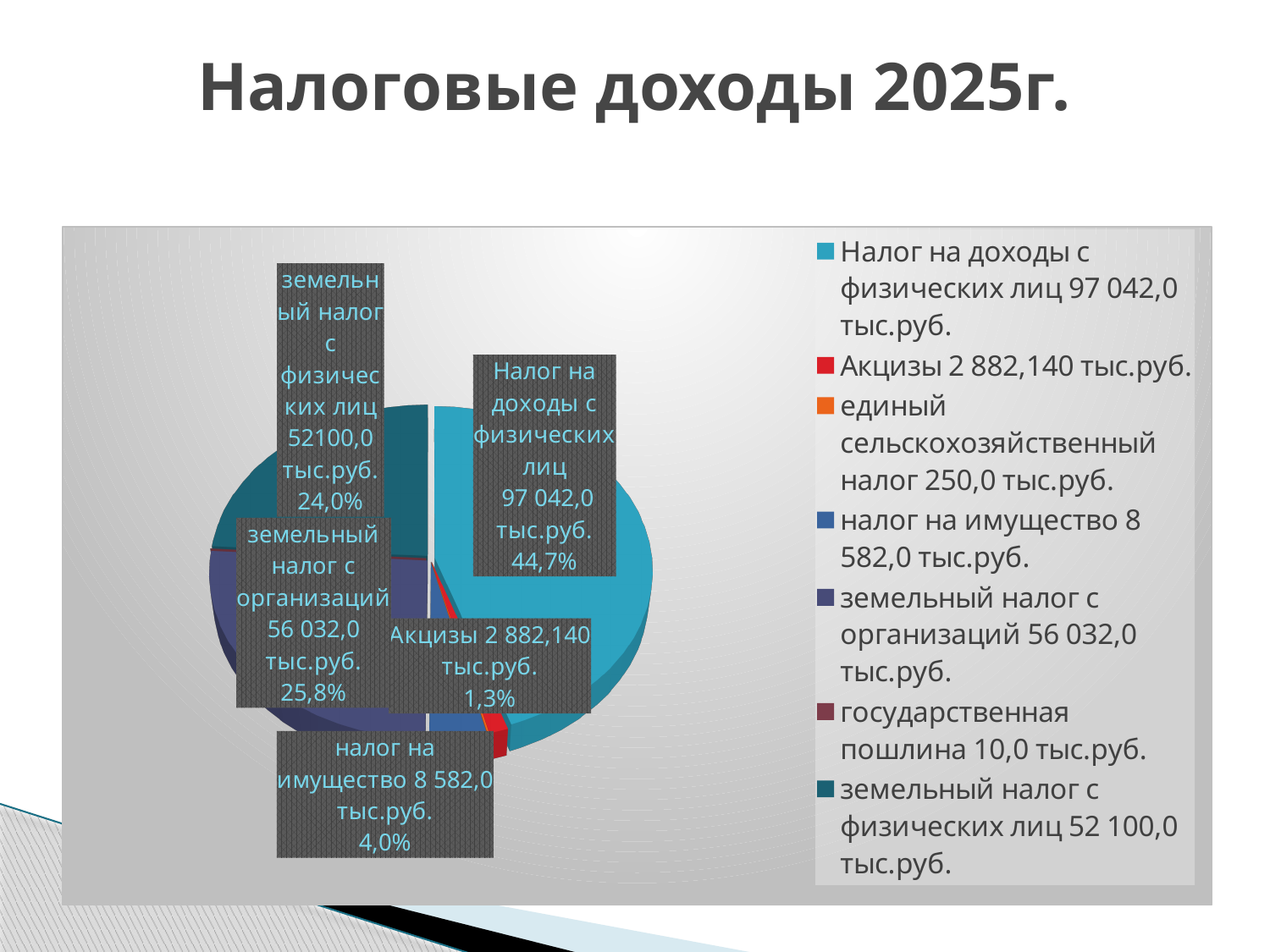
What share of the pie does "Налог на доходы с физических лиц" have? 44,7% Which is larger: the share for "земельный налог с организаций" or the share for "налог на имущество"? земельный налог с организаций What share of the pie does "земельный налог с организаций" have? 25,8% What kind of chart is shown on the slide? pie chart How many categories does the legend of the pie chart list? 7 Which category has the largest share of the pie? Налог на доходы с физических лиц What share of the pie does "Акцизы" have? 1,3% What is the value for "Акцизы" according to the legend? 2 882,140 тыс.руб. What is the title of the slide? Налоговые доходы 2025г. What is the value for "государственная пошлина" according to the legend? 10,0 тыс.руб.